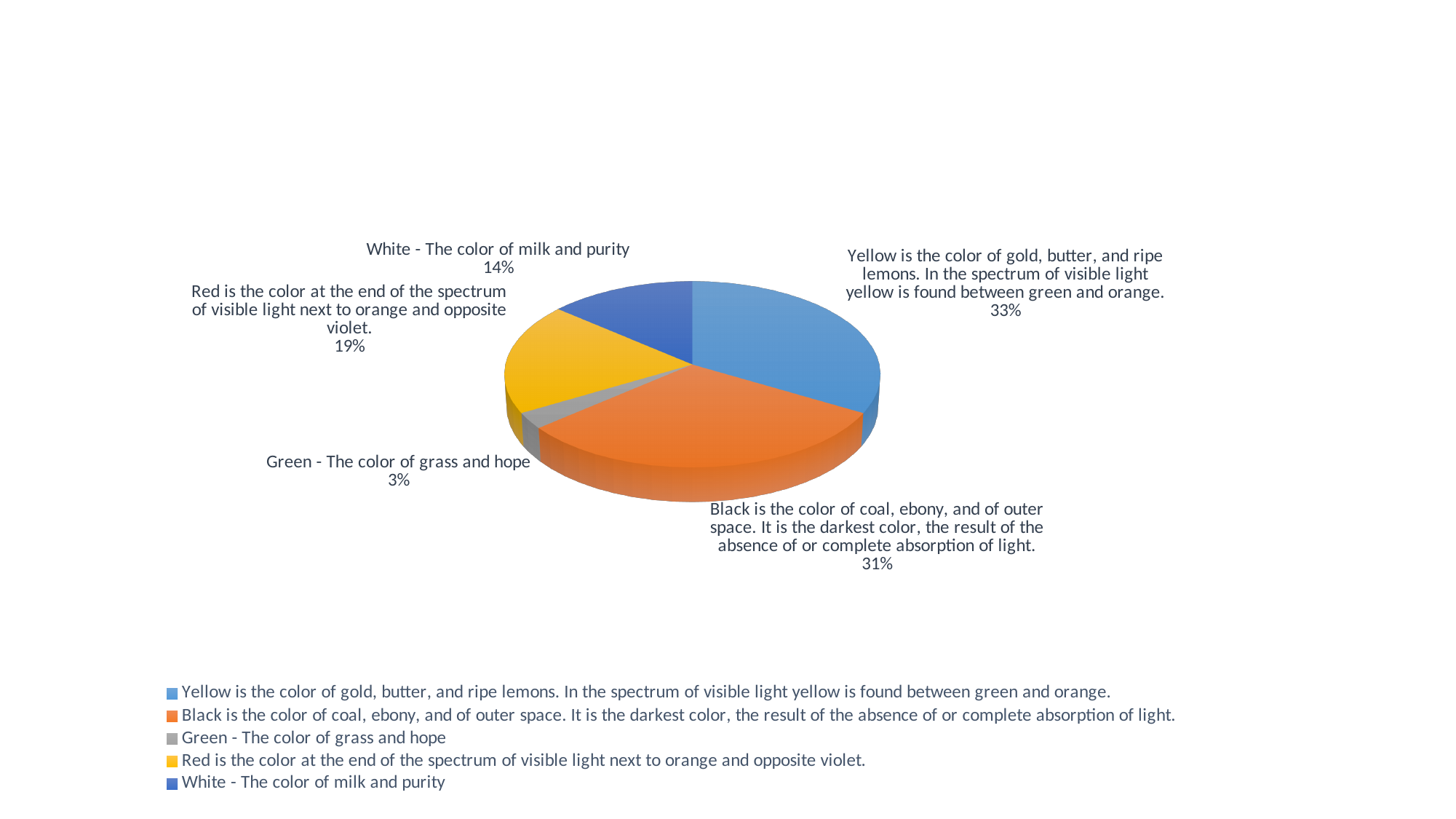
What share of the pie does the "Green - The color of grass and hope" slice represent? 3% Which slice has the largest share of the pie? Yellow is the color of gold, butter, and ripe lemons. In the spectrum of visible light yellow is found between green and orange. Which slice has the smallest share of the pie? Green - The color of grass and hope What colour is the slice for "Green - The color of grass and hope"? grey What share of the pie does the "Yellow" slice represent? 33% What share of the pie does the "White - The color of milk and purity" slice represent? 14% Which slice is larger, "Red" or "White"? Red is the color at the end of the spectrum of visible light next to orange and opposite violet. How many slices does the pie chart have? 5 What is the difference in percentage points between the "Red" slice and the "White" slice? 5 What kind of chart is shown on the slide? pie chart